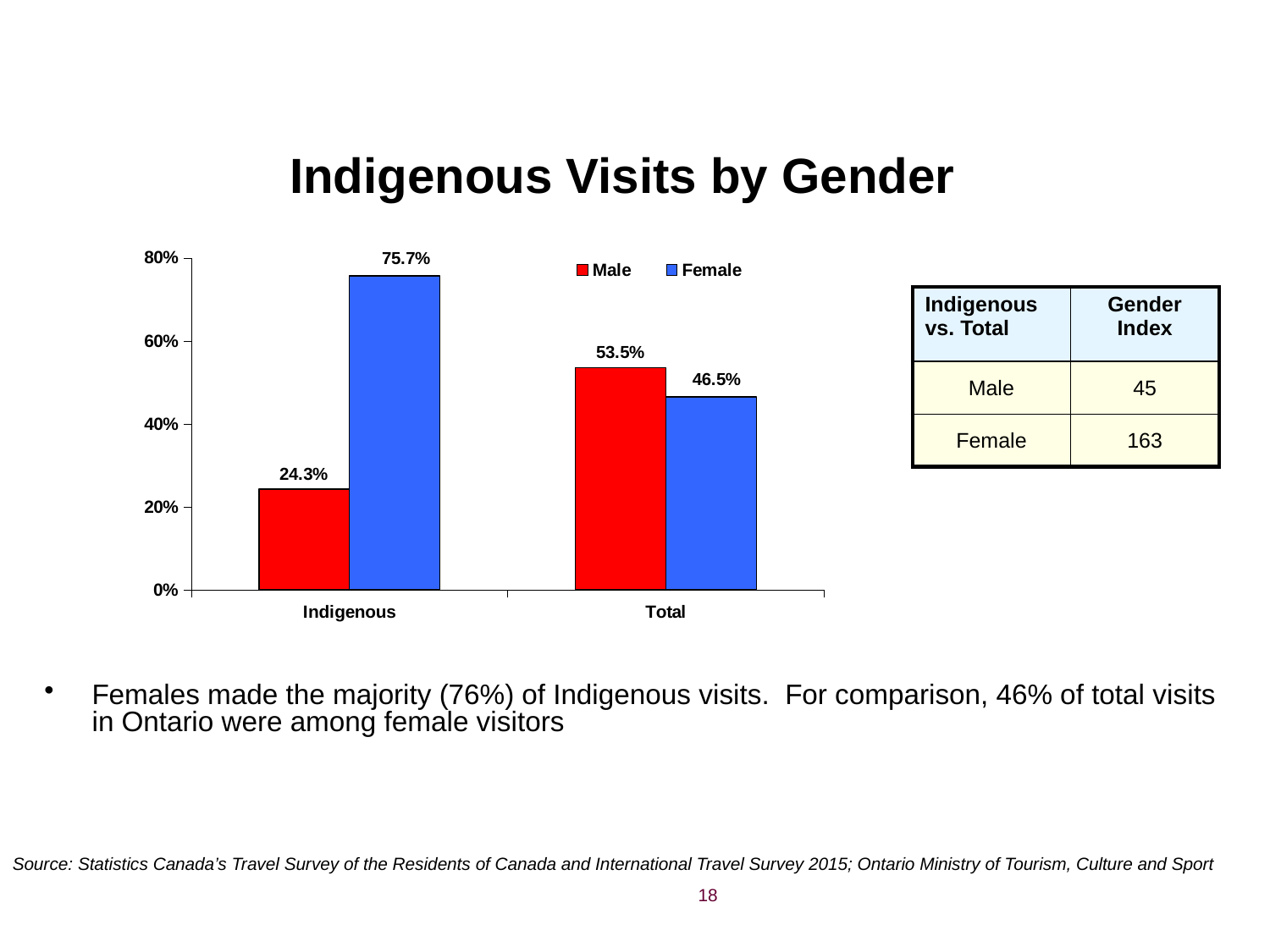
For the Total category, is the Male or Female value larger? Male What is the difference between the Male and Female values for the Total category? 7.0% How many series does the legend list? 2 What is the difference between the Female and Male values for the Indigenous category? 51.4% What is the Male value for the Total category? 53.5% What is the Male value for the Indigenous category? 24.3% What is the Female value for the Total category? 46.5% What is the Female value for the Indigenous category? 75.7% Which bar in the chart has the highest value? Female, Indigenous Which bar in the chart has the lowest value? Male, Indigenous Is the Female value for the Indigenous category greater or less than 60%? greater What kind of chart is shown on the slide? Bar chart